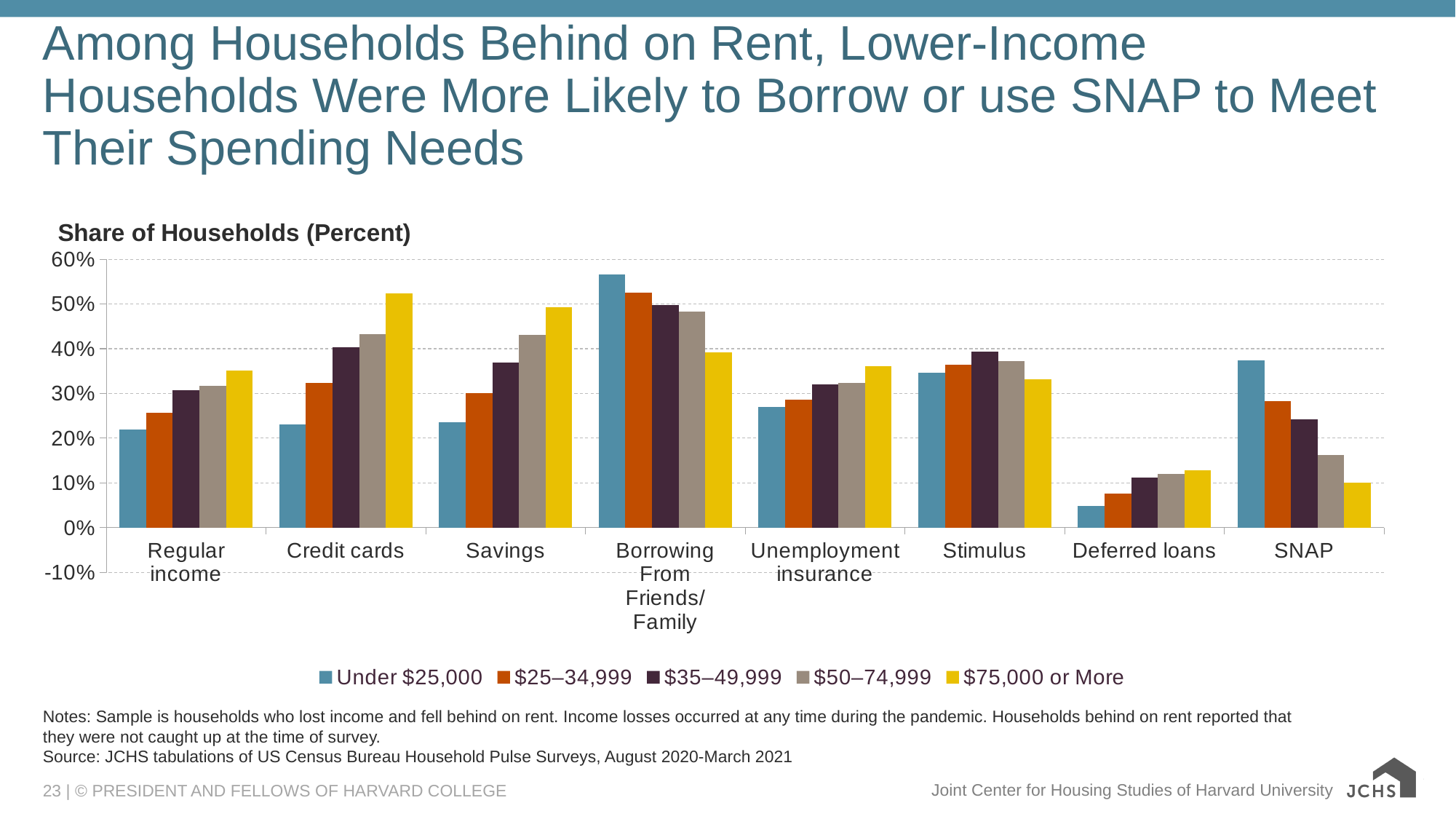
For the Under $25,000 group, which category has the highest share of households? Borrowing From Friends/Family Is the value for $75,000 or More in Credit cards greater or less than 40%? greater Is the value for Under $25,000 in Deferred loans greater or less than 10%? less How many spending-source categories are shown on the x axis? 8 For Credit cards, which income group has the highest share of households? $75,000 or More How many income groups does the legend list? 5 For the Under $25,000 group, which category has the lowest share of households? Deferred loans What is the axis title shown above the chart? Share of Households (Percent) Is the value for Under $25,000 in Borrowing From Friends/Family greater or less than 50%? greater For SNAP, do the values rise or fall as income group increases from Under $25,000 to $75,000 or More? fall For SNAP, which is larger: the value for Under $25,000 or the value for $75,000 or More? Under $25,000 What kind of chart is shown on the slide? bar chart